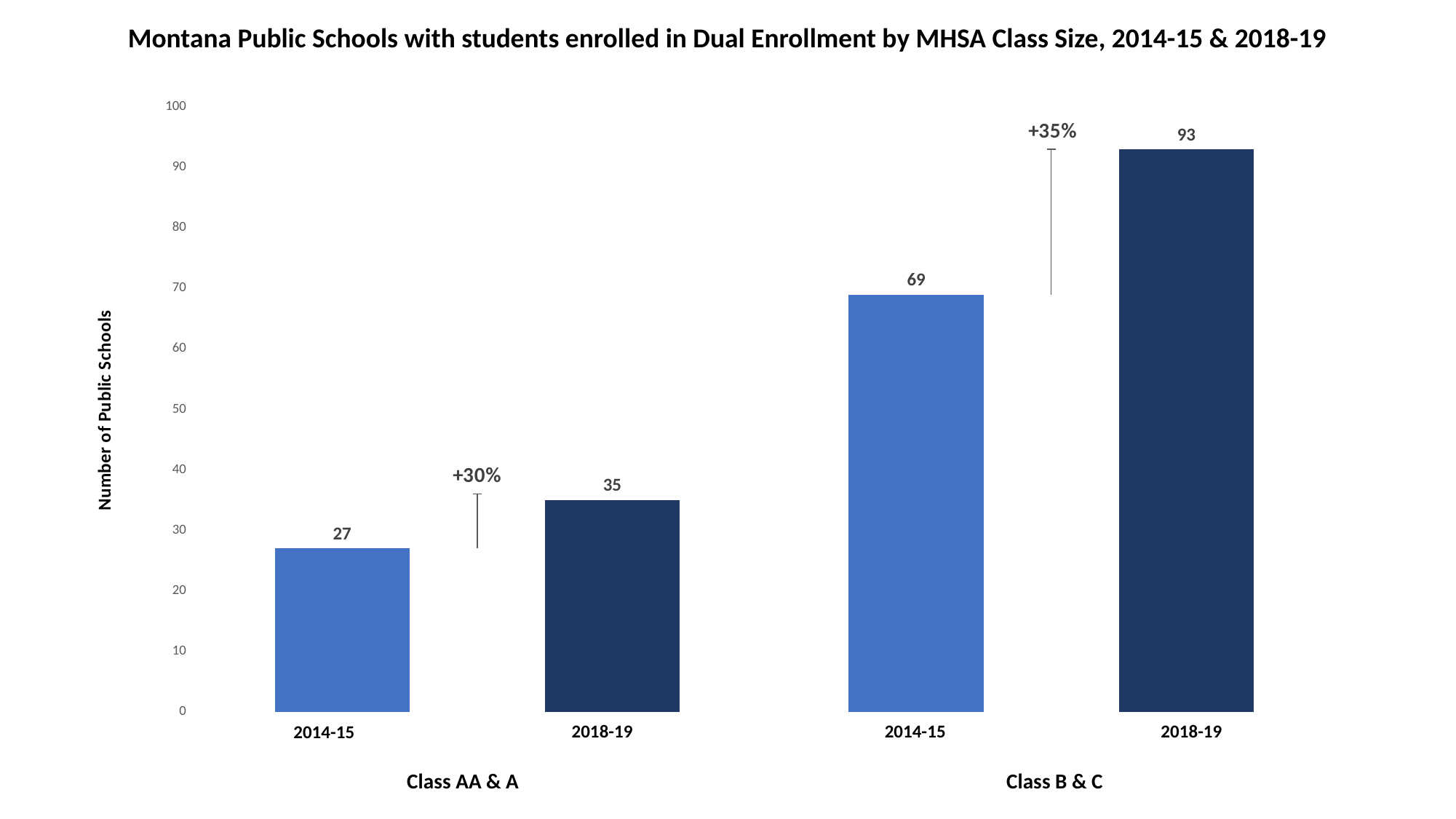
Which bar shows the lowest number of public schools? Class AA & A, 2014-15 What percentage change is labelled between 2014-15 and 2018-19 for Class B & C? +35% How many public schools in Class B & C had students enrolled in Dual Enrollment in 2018-19? 93 What is the difference between the 2018-19 and 2014-15 values for Class AA & A? 8 Which is larger: the 2018-19 value for Class AA & A or the 2014-15 value for Class B & C? 2014-15 value for Class B & C How many public schools in Class AA & A had students enrolled in Dual Enrollment in 2018-19? 35 How many public schools in Class AA & A had students enrolled in Dual Enrollment in 2014-15? 27 How many public schools in Class B & C had students enrolled in Dual Enrollment in 2014-15? 69 Which bar shows the highest number of public schools? Class B & C, 2018-19 How many bars are plotted on the chart? 4 What is the difference between the 2018-19 and 2014-15 values for Class B & C? 24 What type of chart is shown on the slide? Bar chart